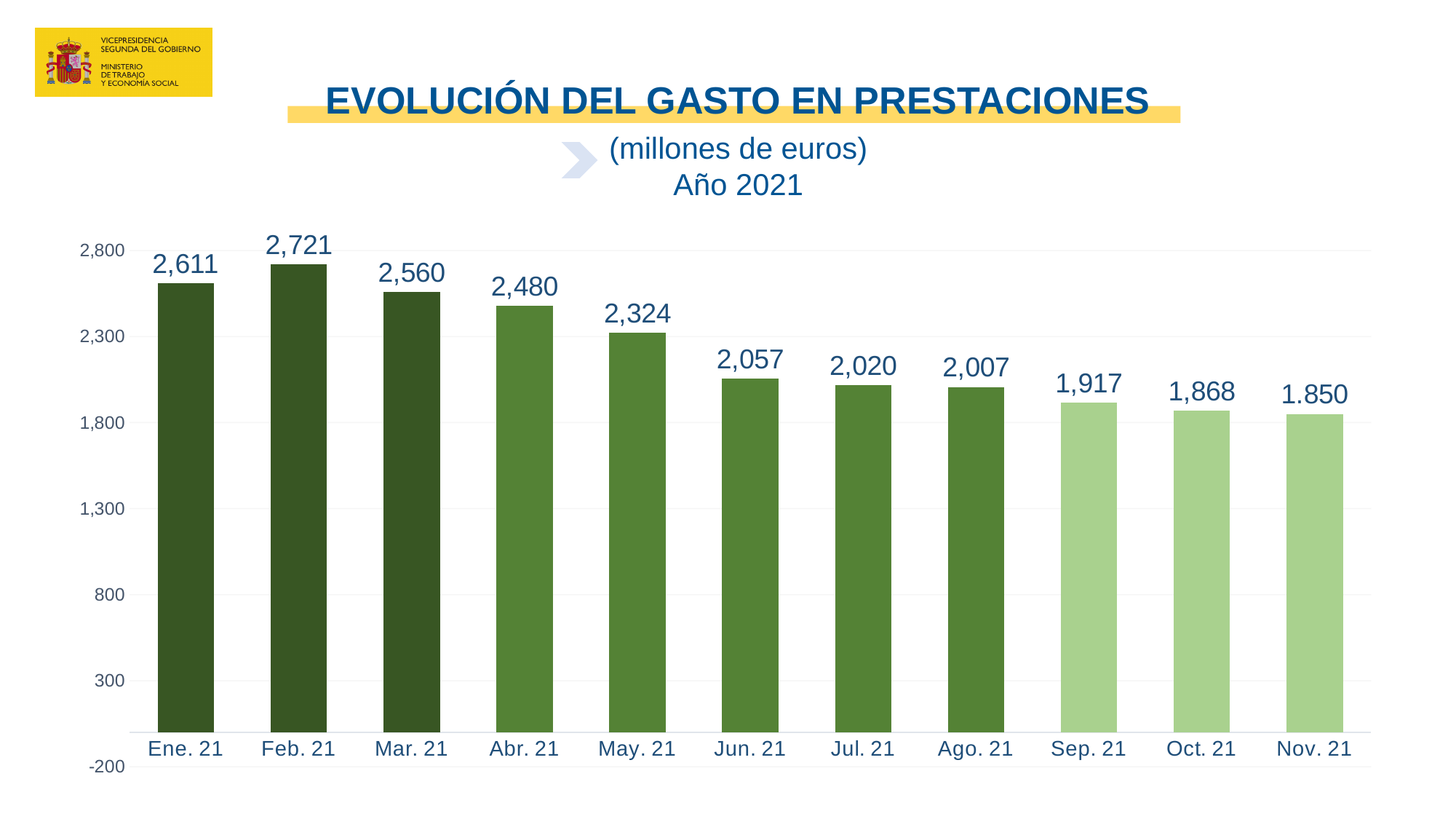
Which month has the highest value? Feb. 21 What is the value for Nov. 21? 1.850 What is the difference between the values for Ene. 21 and Feb. 21? 110 Do the values rise or fall from Ene. 21 to Nov. 21 overall? Fall Is the value for Sep. 21 greater or less than 1,800? greater What is the value for Jun. 21? 2,057 Which month has the lowest value? Nov. 21 What is the value for Feb. 21? 2,721 How many months are shown on the x axis? 11 What kind of chart is shown on the slide? Bar chart Which is larger, the value for Mar. 21 or the value for Abr. 21? Mar. 21 What is the difference between the values for Abr. 21 and May. 21? 156